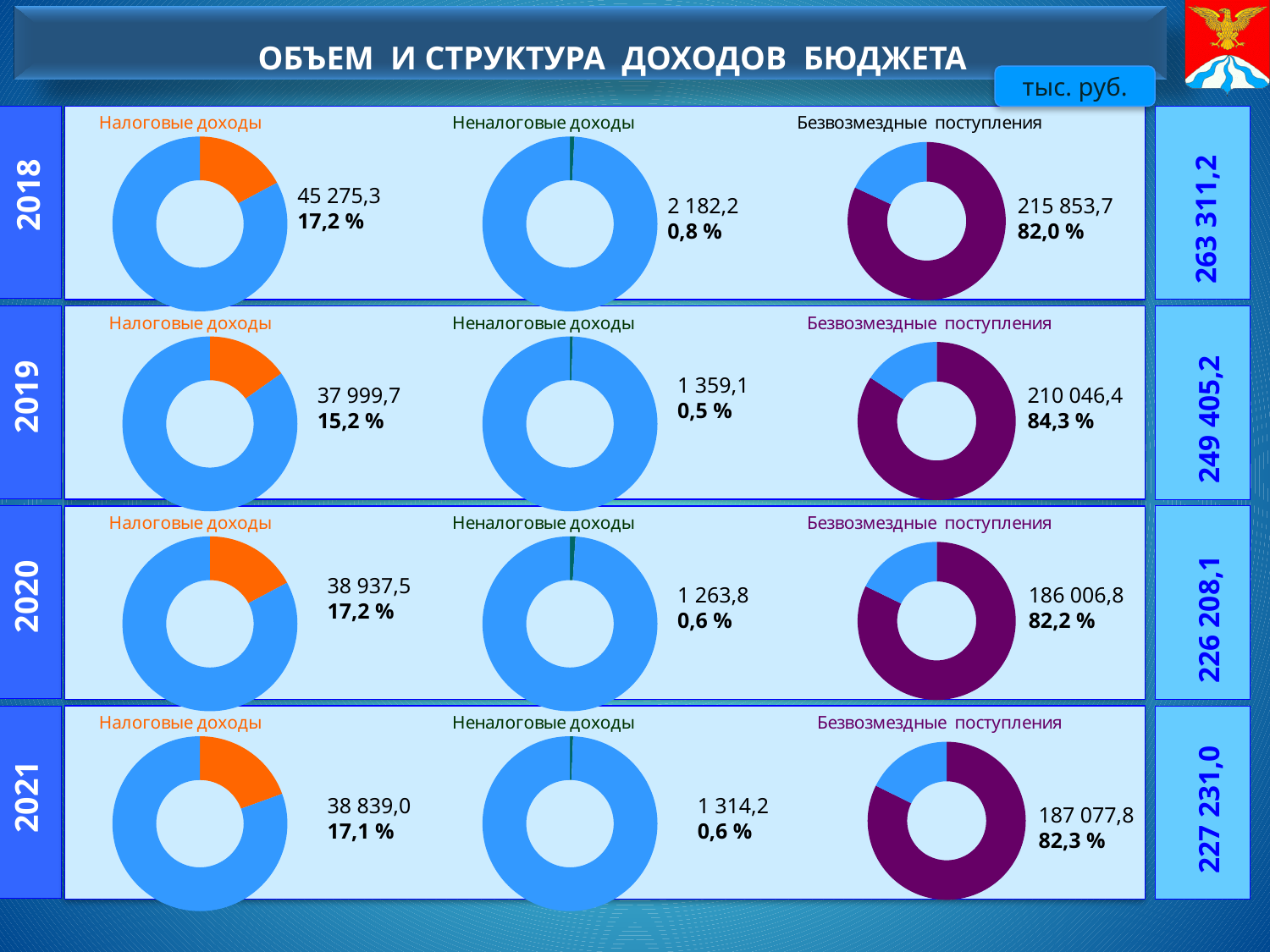
In the 2021 row, what share does the 'Неналоговые доходы' donut chart show? 0,6 % In the 2018 row, what share does the 'Безвозмездные поступления' donut chart show? 82,0 % In the 2019 row, what share does the 'Налоговые доходы' donut chart show? 15,2 % Which is larger: the 'Безвозмездные поступления' value in the 2019 row or in the 2021 row? 2019 In the 2020 row, what value is shown on the 'Безвозмездные поступления' donut chart? 186 006,8 How many donut charts are shown on the slide in total? 12 In the 2018 row, what value is shown on the 'Налоговые доходы' donut chart? 45 275,3 Across the four 'Неналоговые доходы' donut charts, which year shows the lowest value? 2020 In the 2019 row, what value is shown on the 'Неналоговые доходы' donut chart? 1 359,1 Across the four 'Налоговые доходы' donut charts, which year shows the highest value? 2018 What type of chart is used for each category on this slide? Donut (pie) chart What is the difference between the 'Налоговые доходы' value in the 2018 row and in the 2019 row? 7 275,6